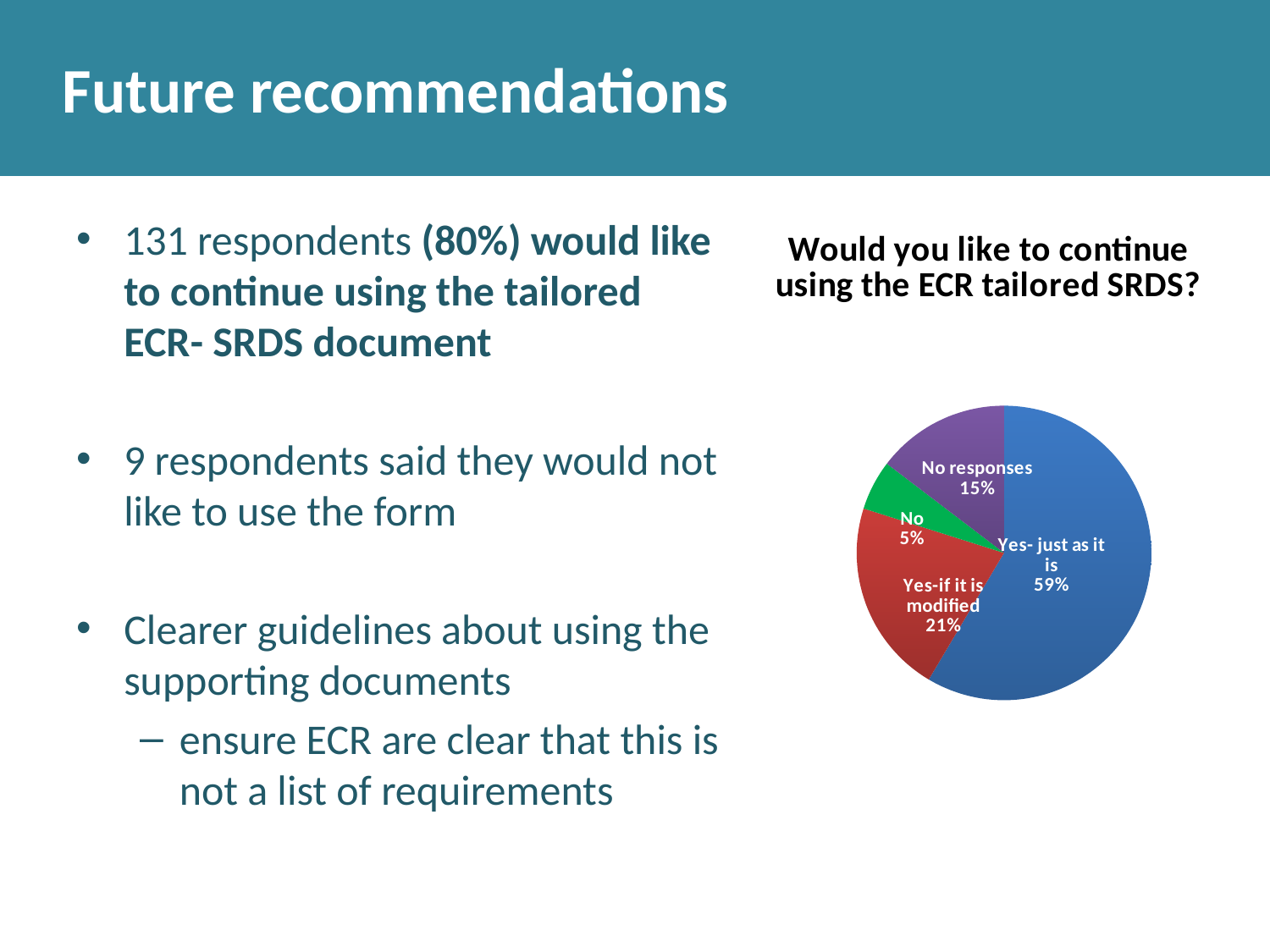
What share of the pie is labelled "No responses"? 15% Which slice of the pie is the smallest? No What is the title of the chart? Would you like to continue using the ECR tailored SRDS? What share of the pie is labelled "No"? 5% What is the difference in percentage points between the "Yes- just as it is" slice and the "Yes-if it is modified" slice? 38 What kind of chart is shown on the slide? pie chart What share of the pie is labelled "Yes- just as it is"? 59% How many slices does the pie chart have? 4 Which is larger, the "No responses" slice or the "No" slice? No responses What colour is the "No" slice of the pie? green Which slice of the pie is the largest? Yes- just as it is